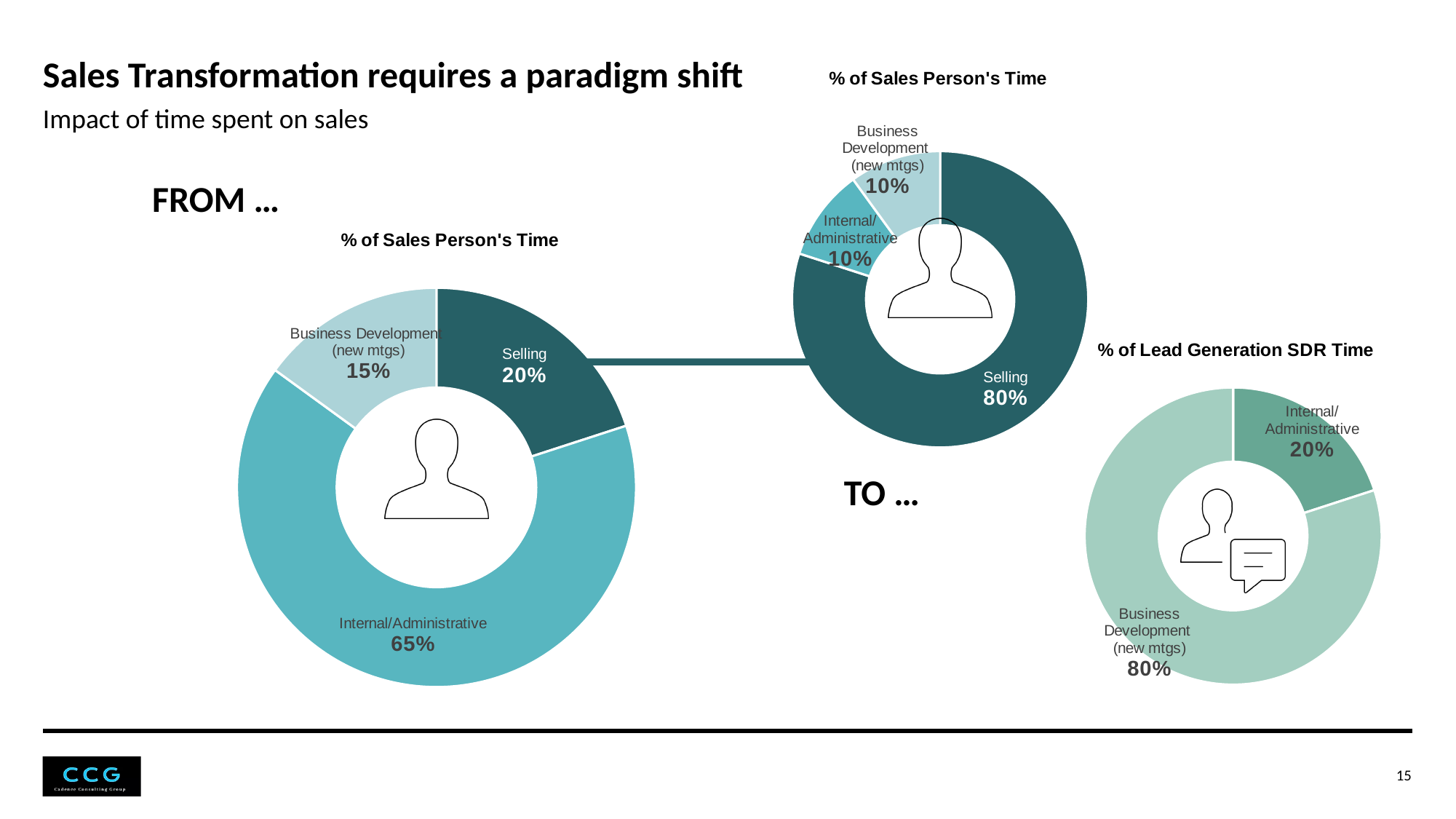
In the '% of Lead Generation SDR Time' chart, which is larger: Internal/Administrative or Business Development (new mtgs)? Business Development (new mtgs) In the 'FROM' chart on the left (% of Sales Person's Time), what share of time is spent on Business Development (new mtgs)? 15% In the 'FROM' chart on the left (% of Sales Person's Time), what share of time is spent on Internal/Administrative work? 65% In the 'TO' chart at the top right (% of Sales Person's Time), what share of time is spent on Internal/Administrative work? 10% What kind of chart is the '% of Lead Generation SDR Time' chart? Donut (pie) chart In the 'FROM' chart on the left (% of Sales Person's Time), which category takes the smallest share of time? Business Development (new mtgs) In the 'TO' chart at the top right (% of Sales Person's Time), what share of time is spent on Selling? 80% In the 'FROM' chart on the left (% of Sales Person's Time), what is the difference between the Internal/Administrative share and the Selling share? 45% In the '% of Lead Generation SDR Time' chart, what share of time is spent on Business Development (new mtgs)? 80% In the 'FROM' chart on the left (% of Sales Person's Time), which category takes the largest share of time? Internal/Administrative In the 'TO' chart at the top right (% of Sales Person's Time), how many categories are shown? 3 In the 'FROM' chart on the left (% of Sales Person's Time), what share of time is spent on Selling? 20%